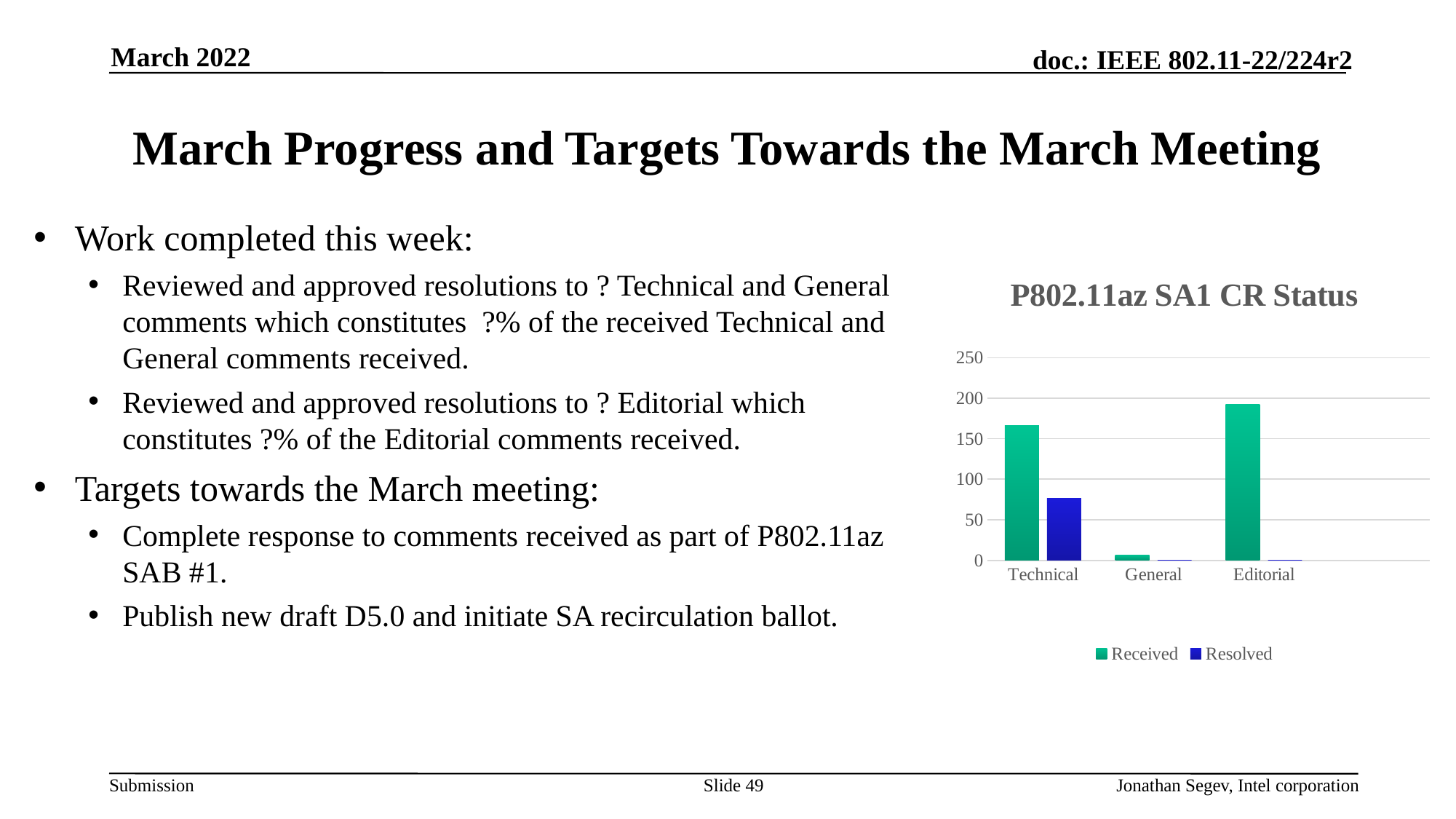
What is the title of the chart? P802.11az SA1 CR Status Is the Received value for Technical greater or less than 150? greater Which category has the lowest Received value? General Which category has the highest Received value? Editorial What kind of chart is shown on the slide? bar chart Is the Received value for Editorial greater or less than 200? less Which category has the highest Resolved value? Technical How many categories are shown on the x axis of the chart? 3 Is the Resolved value for Technical greater or less than 50? greater How many series does the chart's legend list? 2 Which series is shown in blue in the chart's legend? Resolved For Technical, which is larger: Received or Resolved? Received